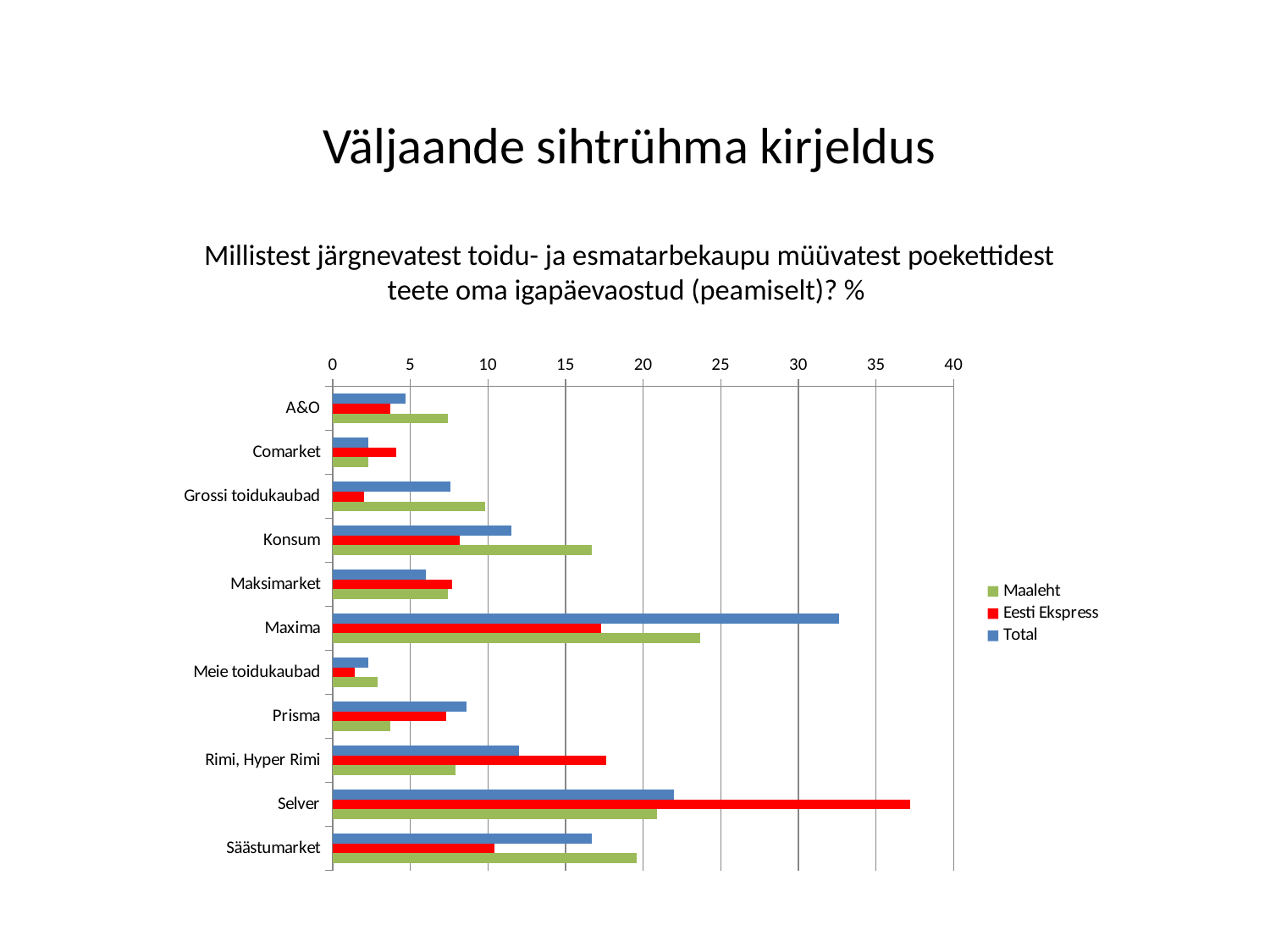
How many series does the legend list? 3 Which store has the highest value for the Total series? Maxima Is the Eesti Ekspress value for Selver greater or less than 35? greater For Selver, which is larger: the Eesti Ekspress value or the Total value? Eesti Ekspress Which series is shown in red in the legend? Eesti Ekspress Which store has the highest value for the Maaleht series? Maxima Is the Total value for Maxima greater or less than 30? greater Which store has the highest value for the Eesti Ekspress series? Selver Is the Eesti Ekspress value for Rimi, Hyper Rimi greater or less than 15? greater What kind of chart is shown on the slide? bar chart How many store chains (categories) are listed on the chart? 11